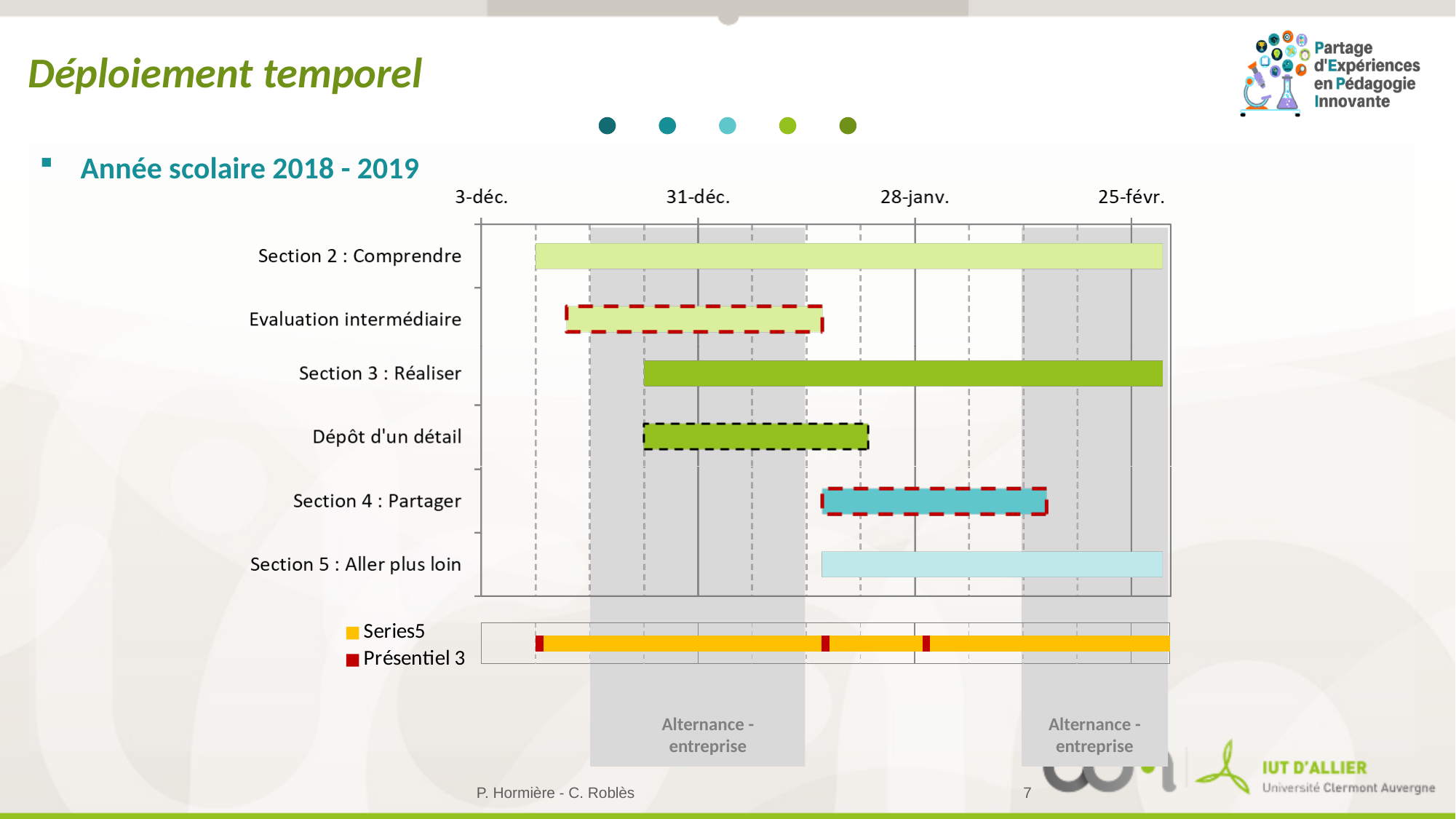
Does the bar for 'Section 4 : Partager' end before or after 25-févr.? before What label is given to the two grey shaded periods on the chart? Alternance - entreprise Does the bar for 'Section 5 : Aller plus loin' start before or after 31-déc.? after How many entries does the legend below the chart list? 2 How many activity rows (categories) are listed on the vertical axis of the chart? 6 What kind of chart is shown on the slide? Bar chart (Gantt-style timeline) What are the two legend entries shown below the chart? Series5 and Présentiel 3 Which starts earlier, 'Section 3 : Réaliser' or 'Section 4 : Partager'? Section 3 : Réaliser Which activity has the longest bar in the chart? Section 2 : Comprendre